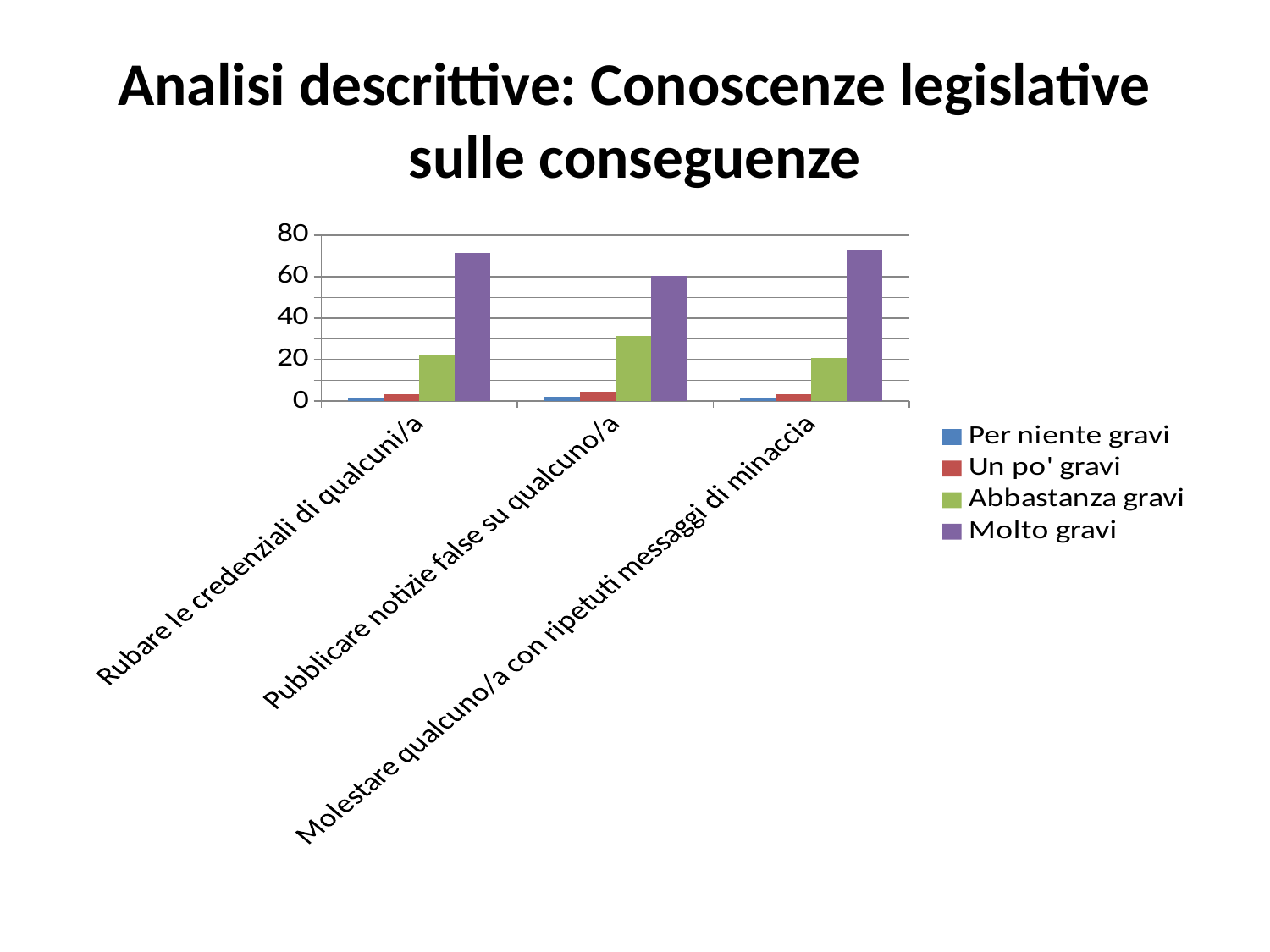
Which series is shown in purple in the legend? Molto gravi How many series does the legend list? 4 Is the value for 'Abbastanza gravi' in the category 'Pubblicare notizie false su qualcuno/a' greater or less than 40? less What kind of chart is shown on the slide? bar chart Is the value for 'Un po' gravi' in the category 'Molestare qualcuno/a con ripetuti messaggi di minaccia' greater or less than 20? less Which is larger: the 'Molto gravi' value for 'Rubare le credenziali di qualcuni/a' or for 'Pubblicare notizie false su qualcuno/a'? Rubare le credenziali di qualcuni/a Is the value for 'Molto gravi' in the category 'Rubare le credenziali di qualcuni/a' greater or less than 60? greater Which series has the lowest value in the category 'Rubare le credenziali di qualcuni/a'? Per niente gravi What is the title of the slide? Analisi descrittive: Conoscenze legislative sulle conseguenze Which category has the highest value for 'Abbastanza gravi'? Pubblicare notizie false su qualcuno/a How many categories are shown on the x axis of the chart? 3